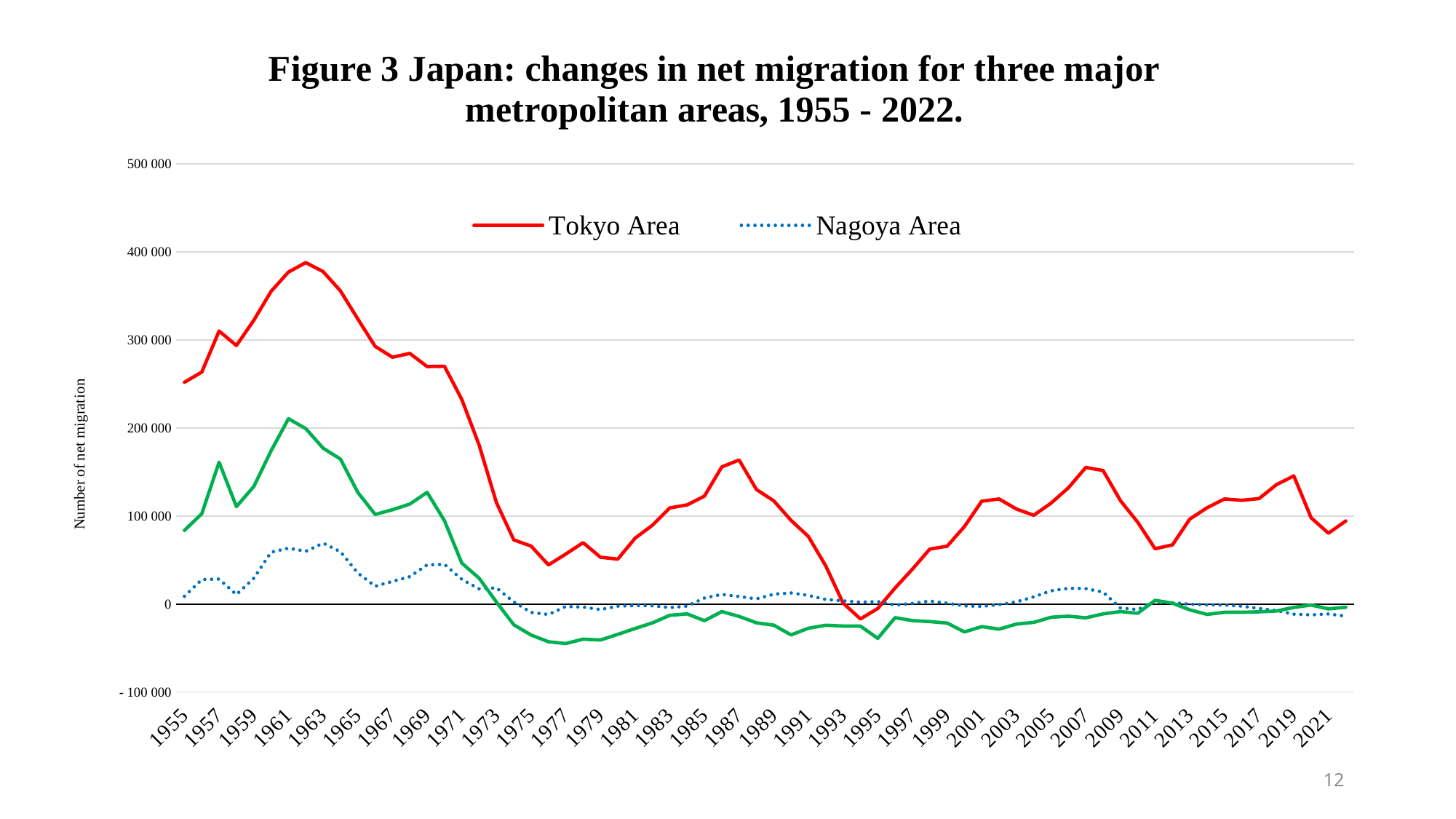
Is the value for Tokyo Area in 1993 greater or less than 100 000? less Which series reaches the highest value on the chart? Tokyo Area Is the value for Tokyo Area in 1961 greater or less than 300 000? greater What is the label on the vertical axis? Number of net migration What is the title of the chart? Figure 3 Japan: changes in net migration for three major metropolitan areas, 1955 - 2022. Is the value for Nagoya Area in 1961 greater or less than 100 000? less In 1961, which series has the larger value, Tokyo Area or Nagoya Area? Tokyo Area Does the Tokyo Area line rise or fall between 1963 and 1973? fall How many series does the legend list? 2 What kind of chart is shown on the slide? line chart